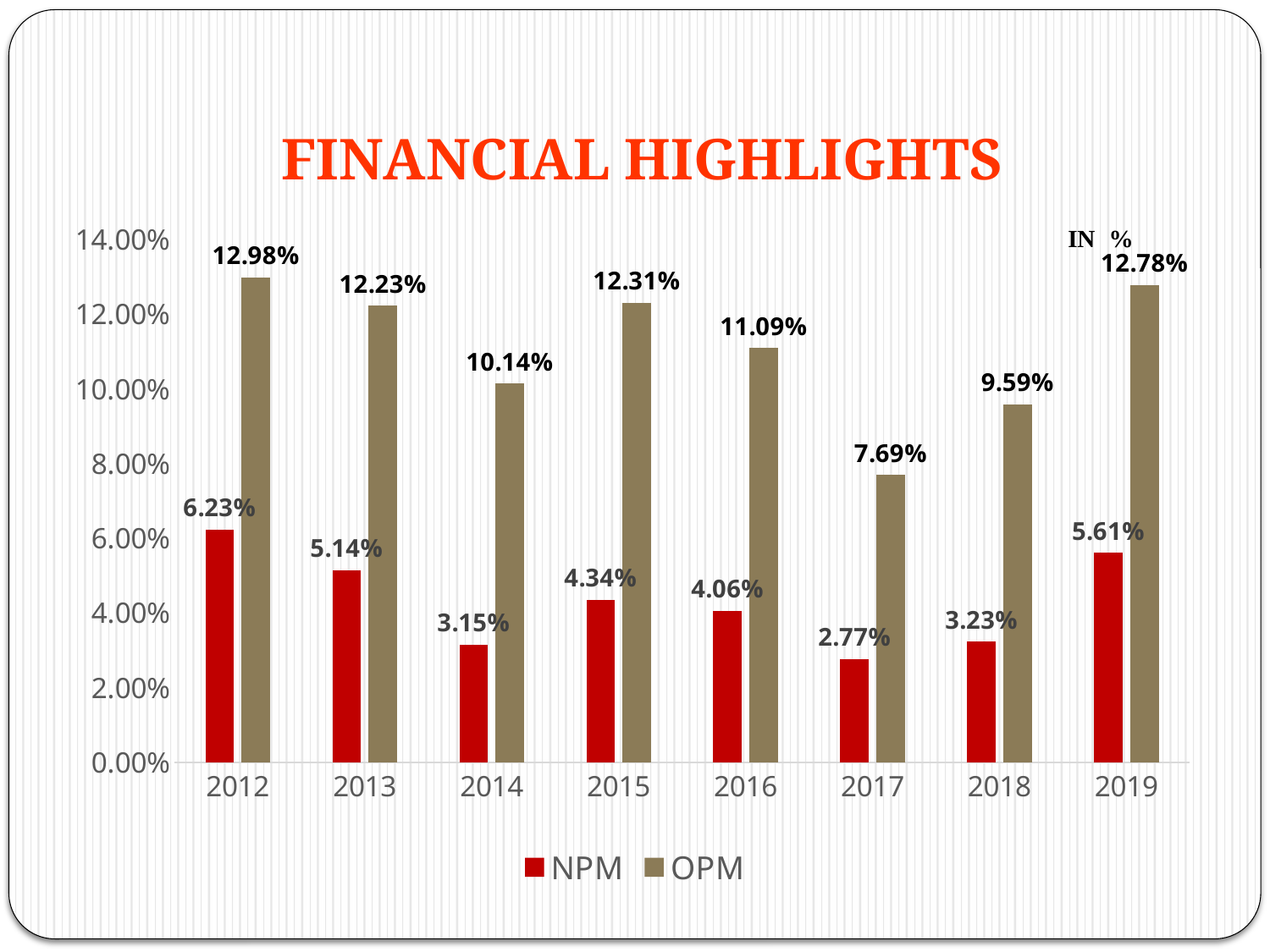
Which is larger, the NPM value for 2013 or the NPM value for 2018? 2013 Is the OPM value for 2017 greater or less than 8.00%? less Does the NPM value rise or fall from 2012 to 2014? fall What is the NPM value for 2015? 4.34% What is the title of the chart? FINANCIAL HIGHLIGHTS What kind of chart is shown on the slide? bar chart How many years are shown on the x axis? 8 Which year has the lowest NPM value? 2017 How many series does the legend list? 2 Which year has the highest OPM value? 2012 What is the OPM value for 2018? 9.59% What is the difference between the OPM and NPM values in 2019? 7.17%